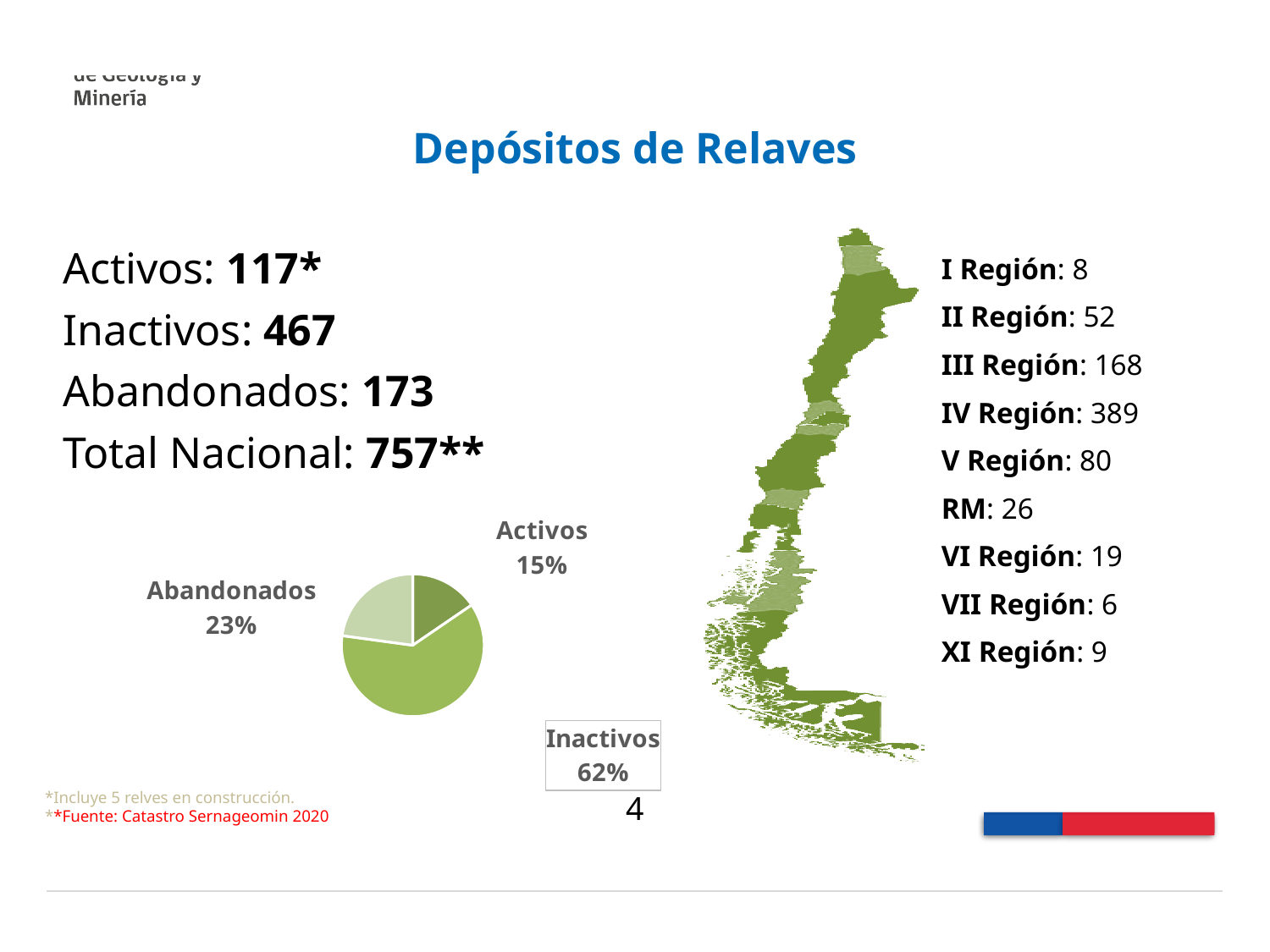
In the pie chart, what is the difference in percentage points between Abandonados and Activos? 8 How many slices does the pie chart have? 3 What share of the pie chart is labelled Inactivos? 62% In the pie chart, what is the difference in percentage points between Inactivos and Activos? 47 What share of the pie chart is labelled Activos? 15% Which slice of the pie chart is the lightest green? Abandonados What share of the pie chart is labelled Abandonados? 23% Which slice of the pie chart is the smallest? Activos Which slice of the pie chart is the largest? Inactivos What kind of chart is shown on the slide? pie chart In the pie chart, which is larger: Abandonados or Activos? Abandonados In the pie chart, what is the difference in percentage points between Inactivos and Abandonados? 39